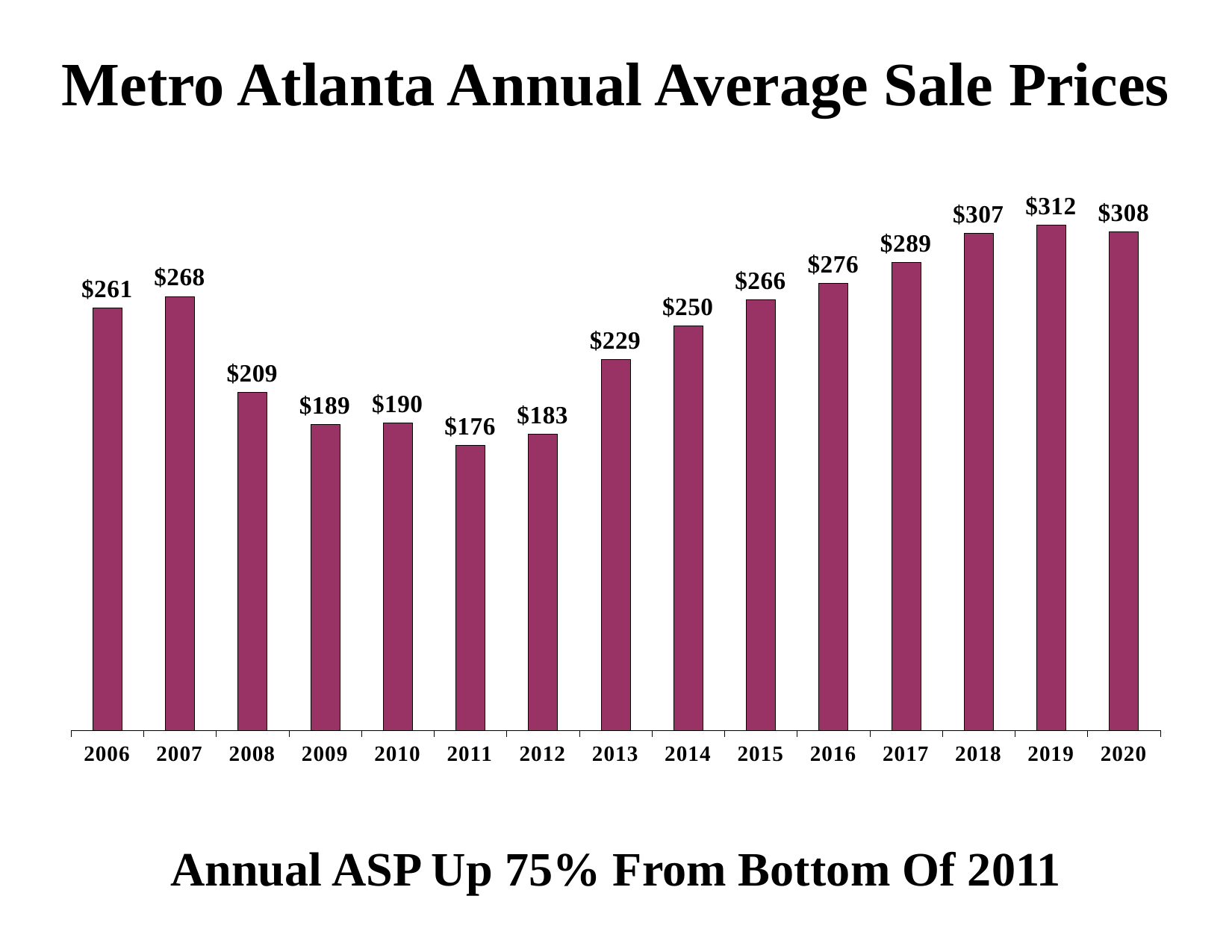
How many years are shown on the x axis? 15 What kind of chart is shown on the slide? Bar chart What is the difference between the 2019 value and the 2011 value? $136 What is the title of the chart? Metro Atlanta Annual Average Sale Prices Which year has the lowest average sale price? 2011 What is the difference between the 2007 value and the 2008 value? $59 Which year has the highest average sale price? 2019 Do the values rise or fall from 2011 to 2019? Rise Which is larger, the value for 2006 or the value for 2015? 2015 Which is larger, the value for 2009 or the value for 2012? 2009 What is the average sale price shown for 2017? $289 What is the average sale price shown for 2011? $176